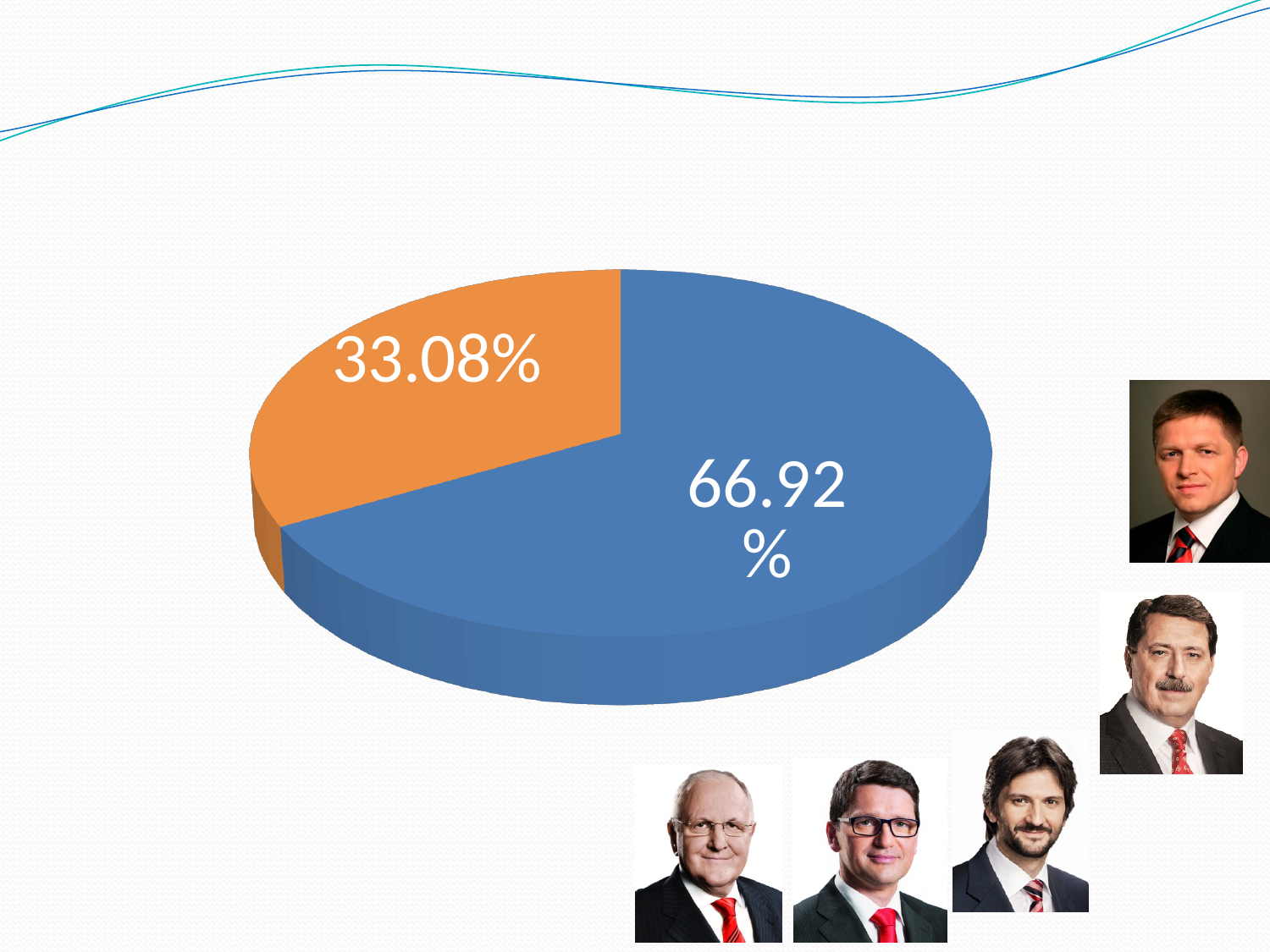
What kind of chart is shown on the slide? pie chart Is the blue slice's share of the pie greater or less than 50%? greater Which slice of the pie chart is the smallest? the orange slice What percentage is shown on the orange slice of the pie chart? 33.08% How many slices does the pie chart have? 2 Which is larger, the blue slice or the orange slice? the blue slice What colours are the two slices of the pie chart? blue and orange Which slice of the pie chart is the largest? the blue slice What share of the pie does the orange slice represent? 33.08% What is the difference between the blue slice's percentage and the orange slice's percentage? 33.84% What percentage is shown on the blue slice of the pie chart? 66.92% Is the orange slice's share of the pie greater or less than 50%? less